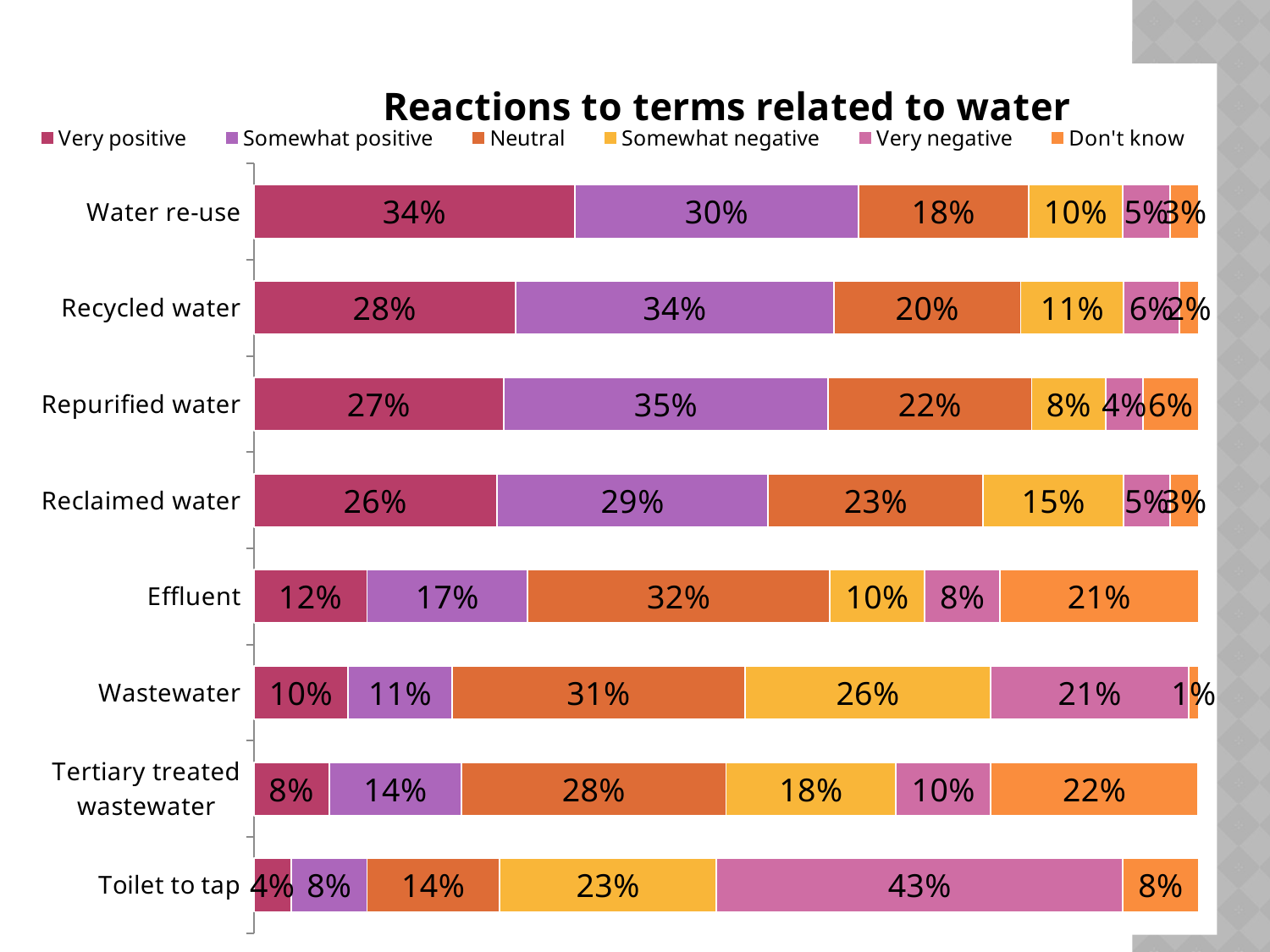
Which term has the highest Very positive value? Water re-use Which is larger: the Somewhat positive value for Repurified water or for Reclaimed water? Repurified water How many series does the legend list? 6 What type of chart is shown on the slide? stacked bar chart What is the Neutral value for Effluent? 32% Which term has the lowest Very positive value? Toilet to tap What is the title of the chart? Reactions to terms related to water What is the Very positive value for Water re-use? 34% What is the Very negative value for Toilet to tap? 43% What is the Don't know value for Tertiary treated wastewater? 22% How many water-related terms (categories) are shown in the chart? 8 What is the difference between the Somewhat negative values for Wastewater and Effluent? 16%